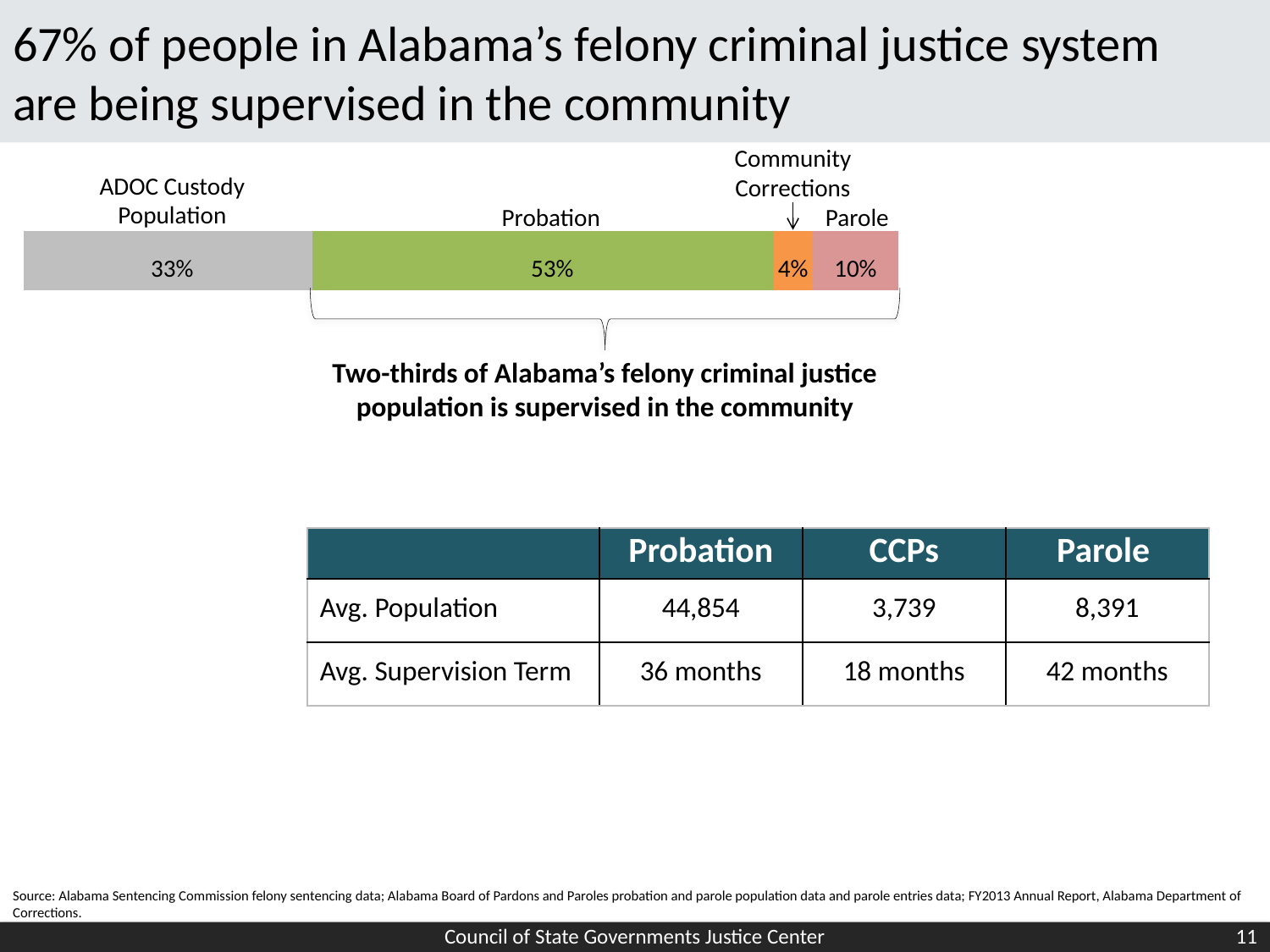
Which is larger, the Parole segment or the Community Corrections segment? Parole Which segment of the bar has the largest share? Probation What colour is the Probation segment of the bar? Green Which segment of the bar has the smallest share? Community Corrections What percentage of the bar is labeled Probation? 53% What percentage of the bar is labeled ADOC Custody Population? 33% What is the difference in percentage points between the Probation segment and the ADOC Custody Population segment? 20 What percentage of the bar is labeled Parole? 10% How many segments does the stacked bar have? 4 What kind of chart is shown on the slide? Stacked bar chart What percentage of the bar is labeled Community Corrections? 4% What is the combined percentage of the Probation, Community Corrections and Parole segments? 67%